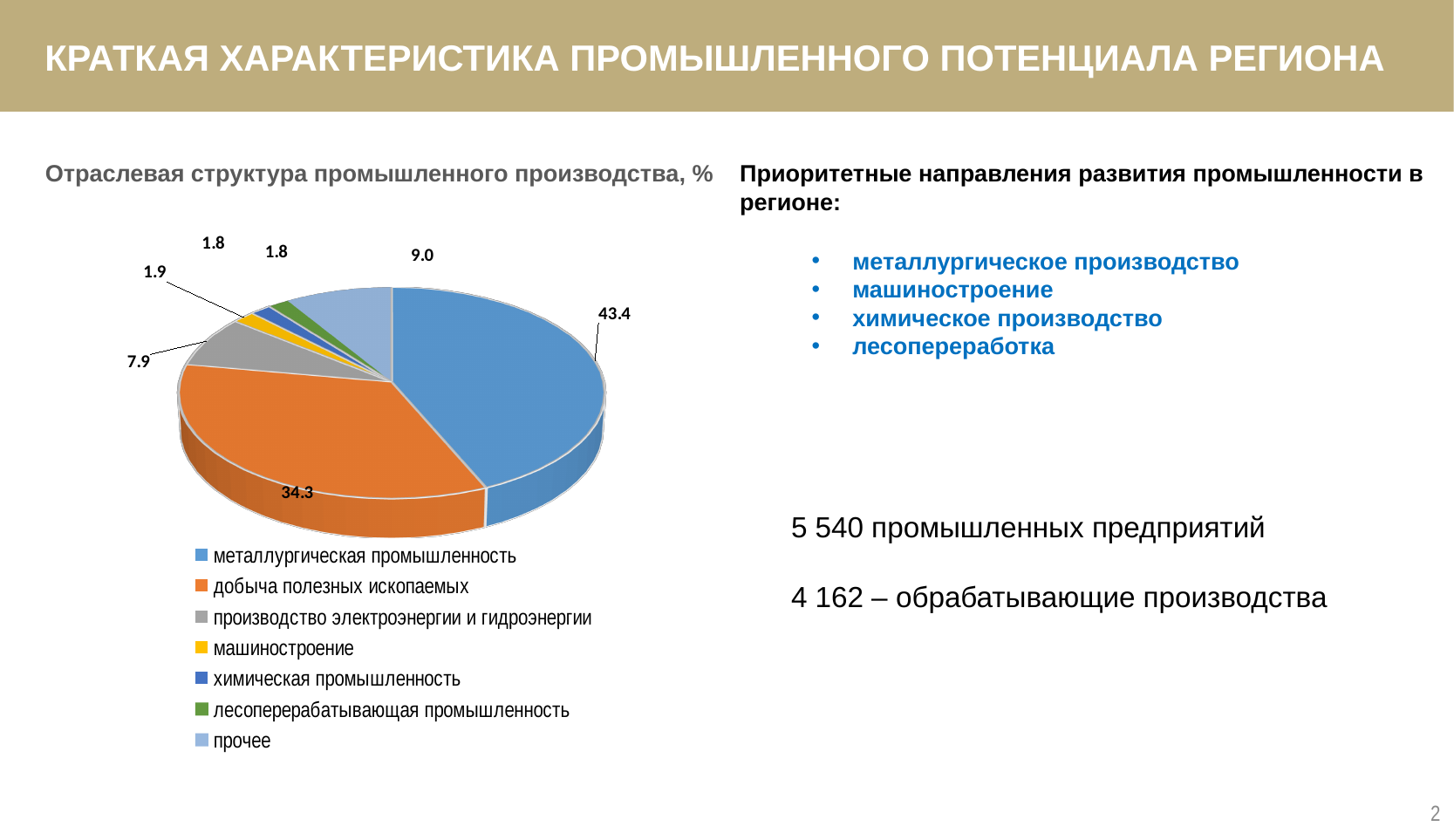
What is the share of производство электроэнергии и гидроэнергии in the pie chart? 7.9 Which colour represents добыча полезных ископаемых in the pie chart? orange What kind of chart is shown on the slide? pie chart What is the share of металлургическая промышленность in the pie chart? 43.4 What is the share of прочее in the pie chart? 9.0 What is the difference between the shares of металлургическая промышленность and добыча полезных ископаемых? 9.1 Which category has the largest slice in the pie chart? металлургическая промышленность How many categories does the pie chart have? 7 What is the share of машиностроение in the pie chart? 1.9 What is the title of the pie chart? Отраслевая структура промышленного производства, % Which is larger: the share of прочее or the share of производство электроэнергии и гидроэнергии? прочее What is the share of добыча полезных ископаемых in the pie chart? 34.3